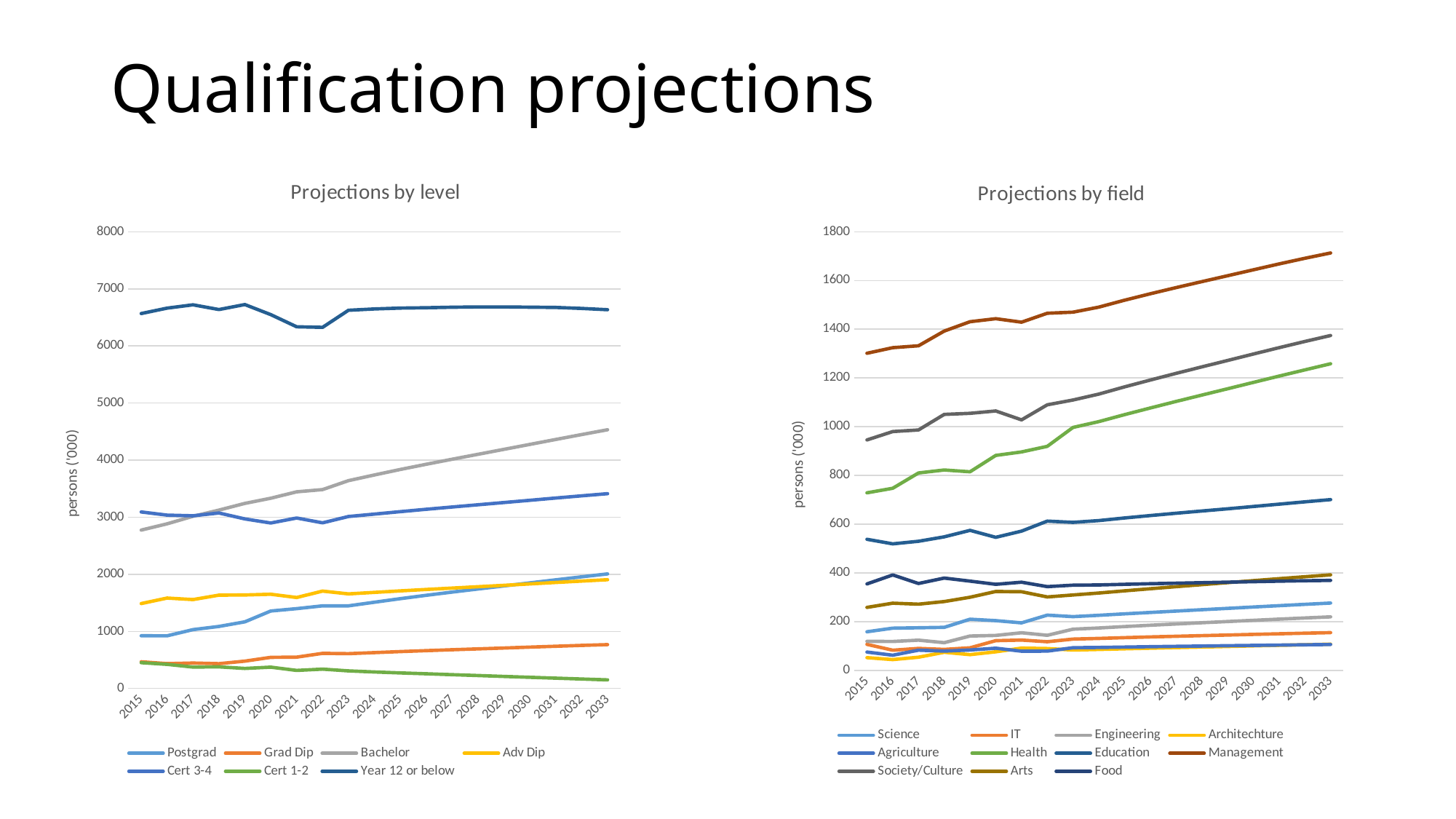
What kind of chart is the 'Projections by level' chart? line chart In the 'Projections by field' chart, is the value for Management in 2033 greater or less than 1600? greater In the 'Projections by field' chart, which series has the highest values across all years? Management In the 'Projections by level' chart, does the Cert 1-2 series rise or fall from 2015 to 2033? fall In the 'Projections by level' chart, which series has the highest values across all years? Year 12 or below What is the y-axis label of the 'Projections by field' chart? persons ('000) How many series does the legend of the 'Projections by level' chart list? 7 How many series does the legend of the 'Projections by field' chart list? 11 In the 'Projections by level' chart, is the value for Bachelor in 2033 greater or less than 4000? greater In the 'Projections by level' chart, which series has the lowest value in 2033? Cert 1-2 In the 'Projections by field' chart, which is larger in 2033, Society/Culture or Health? Society/Culture How many years are plotted along the x axis of the 'Projections by level' chart? 19